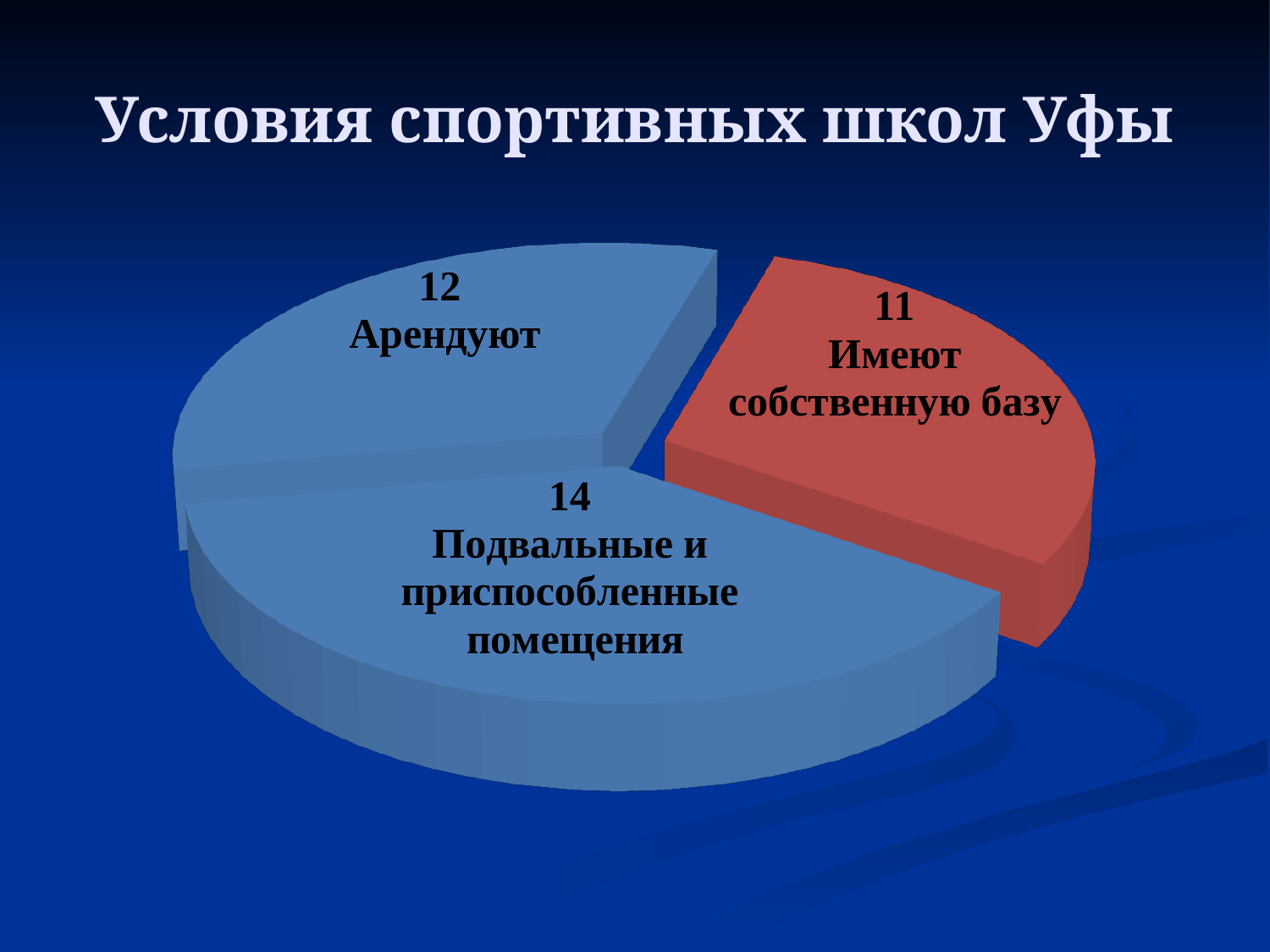
Which is larger, the value for "Арендуют" or the value for "Имеют собственную базу"? Арендуют Which slice has the largest value? Подвальные и приспособленные помещения What is the title of the chart? Условия спортивных школ Уфы Which slice is coloured red? Имеют собственную базу What is the difference between the values for "Подвальные и приспособленные помещения" and "Имеют собственную базу"? 3 What is the total of all three slices in the pie chart? 37 What is the value for the slice labelled "Подвальные и приспособленные помещения"? 14 How many slices does the pie chart have? 3 What is the value for the slice labelled "Арендуют"? 12 What is the value for the slice labelled "Имеют собственную базу"? 11 What type of chart is shown on the slide? Pie chart Which slice has the smallest value? Имеют собственную базу